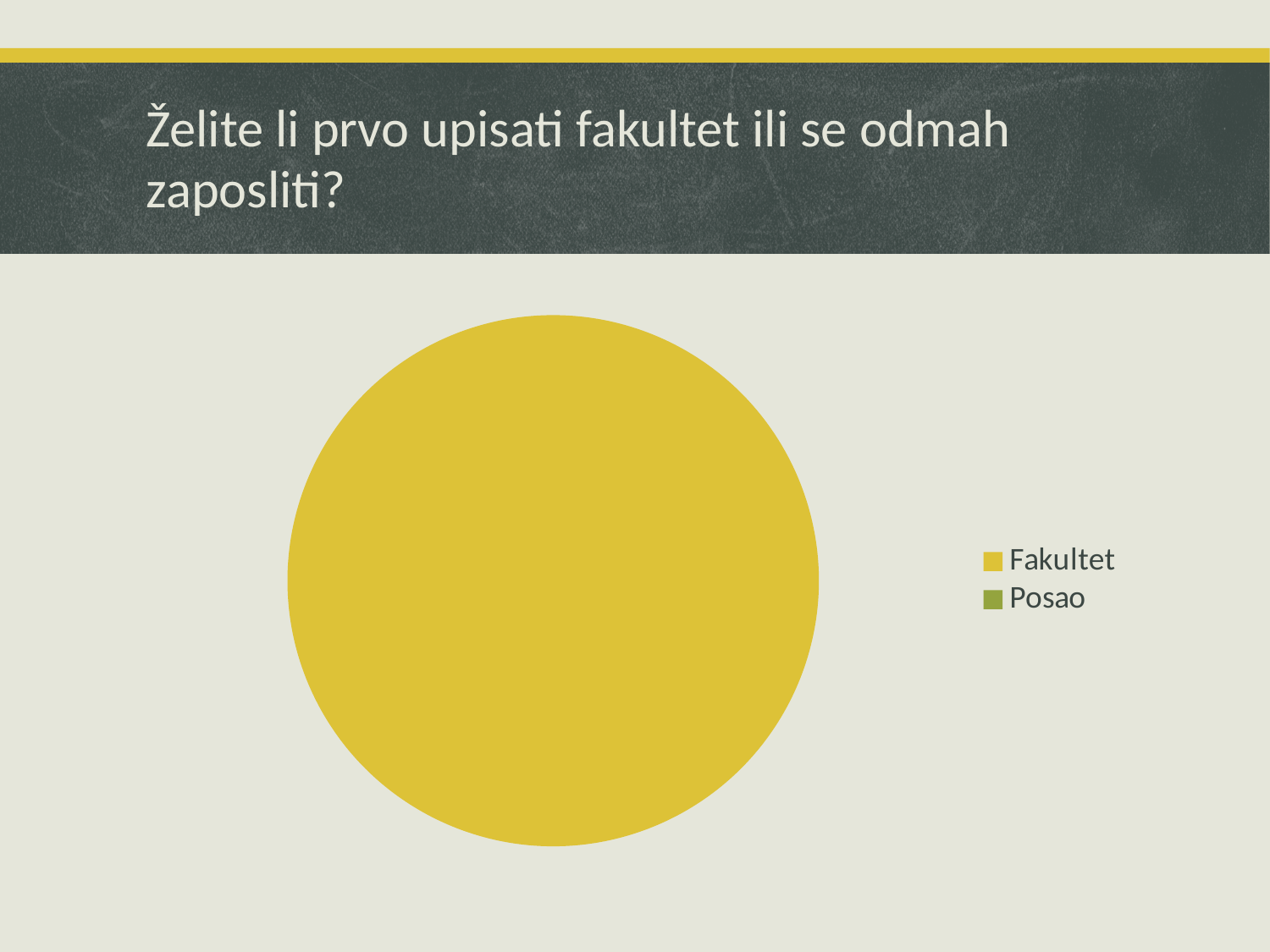
Which category takes up the largest share of the pie chart? Fakultet Which category takes up the smallest share of the pie chart? Posao What kind of chart is shown on the slide? pie chart How many entries does the legend of the pie chart list? 2 What colour represents Fakultet in the pie chart? yellow What are the two categories listed in the legend of the pie chart? Fakultet and Posao Which is larger in the pie chart, the slice for Fakultet or the slice for Posao? Fakultet